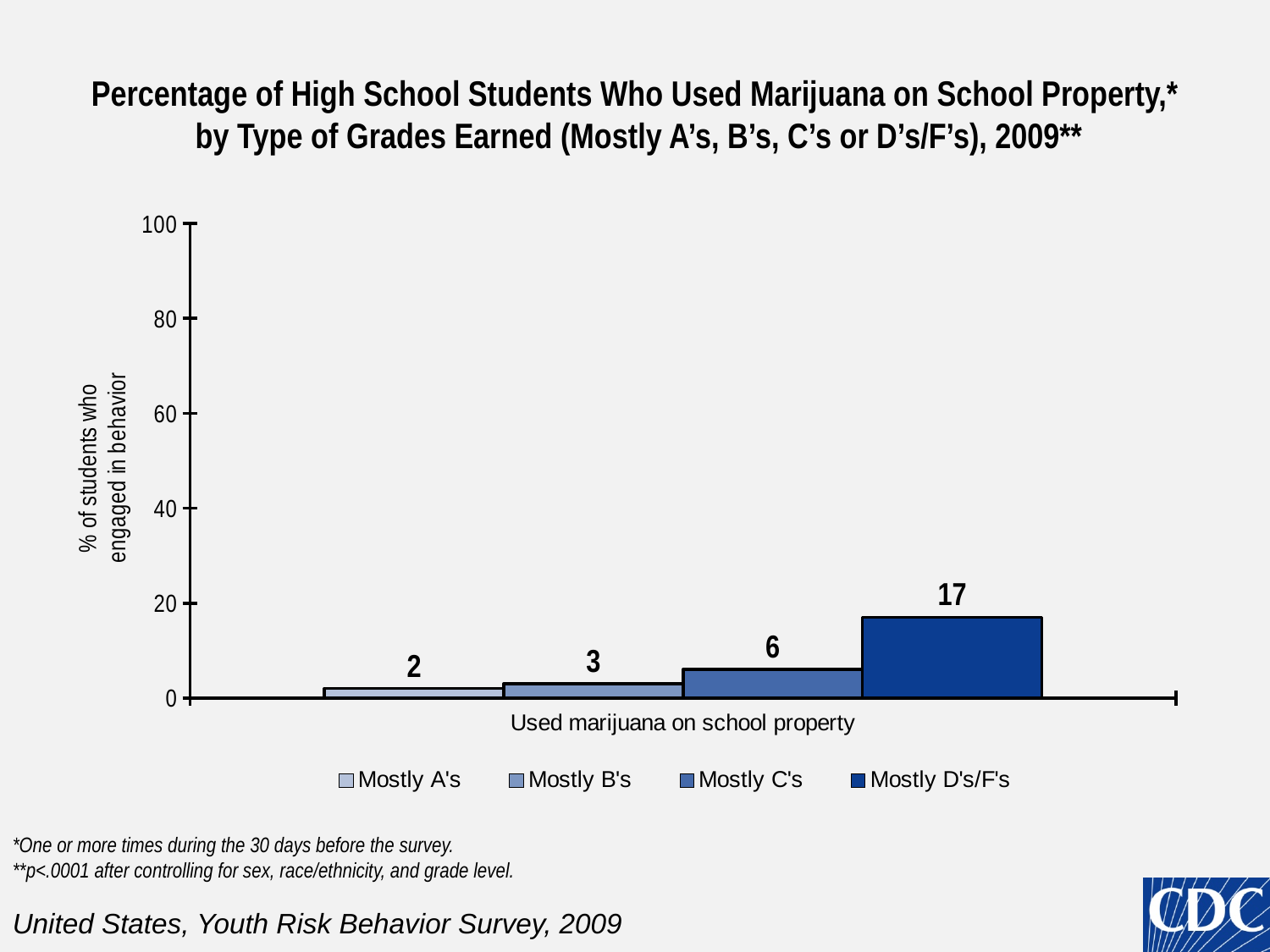
What is the difference between the values for Mostly D's/F's and Mostly A's? 15 Is the value for Mostly D's/F's greater or less than 20? less Which is larger, the value for Mostly B's or Mostly C's? Mostly C's What is the difference between the values for Mostly C's and Mostly B's? 3 What is the value for Mostly C's? 6 Which grade group has the highest percentage of students who used marijuana on school property? Mostly D's/F's How many series does the legend list? 4 What percentage of students with Mostly A's used marijuana on school property? 2 Which grade group has the lowest percentage? Mostly A's What is the label on the y axis? % of students who engaged in behavior What is the value for Mostly D's/F's? 17 What kind of chart is shown on the slide? bar chart